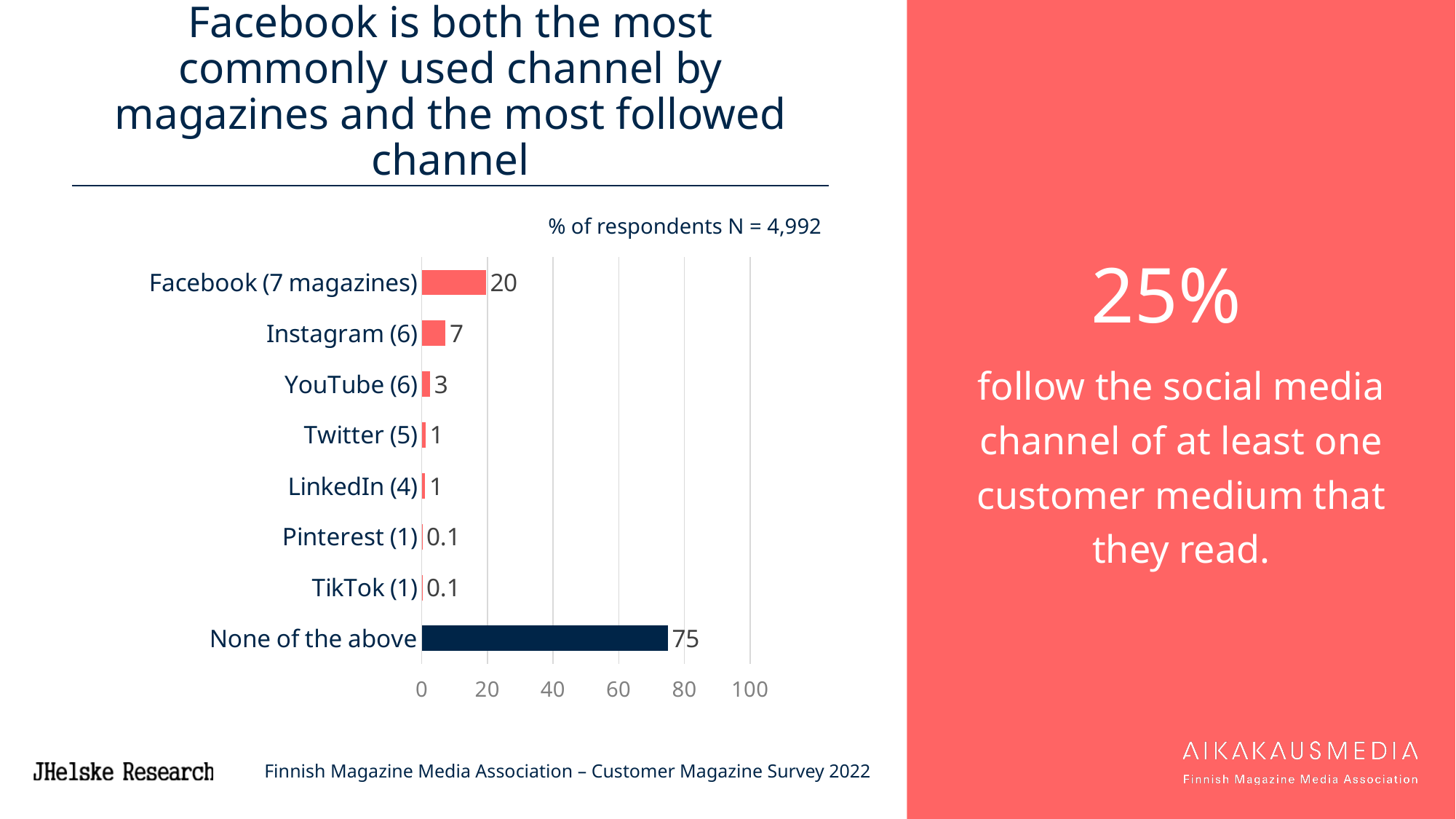
What is the difference between the values for Facebook (7 magazines) and Instagram (6)? 13 What is the value for Facebook (7 magazines)? 20 Which social media channel has the highest value? Facebook (7 magazines) What is the value for None of the above? 75 What is the value for Pinterest (1)? 0.1 What kind of chart is shown on the slide? bar chart How many categories are shown in the chart? 8 What is the value for Instagram (6)? 7 Is the value for None of the above greater or less than 60? greater Which is larger, the value for YouTube (6) or the value for Twitter (5)? YouTube (6) What is the sample size (N) stated above the chart? 4,992 Which category has the highest value? None of the above